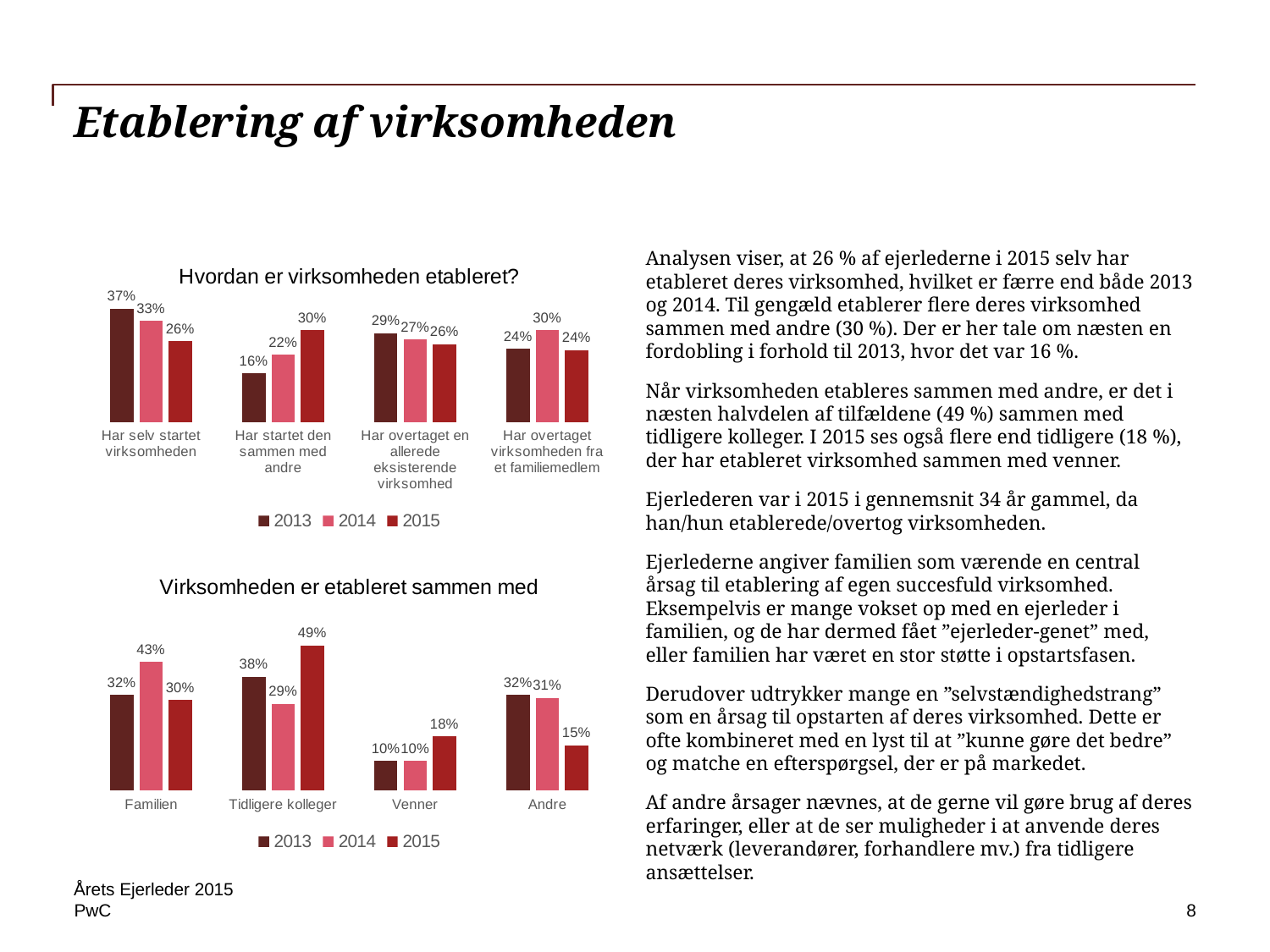
In the chart 'Virksomheden er etableret sammen med', which category has the lowest 2014 value? Venner In the chart 'Virksomheden er etableret sammen med', what is the 2015 value for 'Tidligere kolleger'? 49% In the chart 'Hvordan er virksomheden etableret?', what is the difference between the 2015 and 2013 values for 'Har startet den sammen med andre'? 14% In the chart 'Hvordan er virksomheden etableret?', what is the 2015 value for 'Har selv startet virksomheden'? 26% In the chart 'Hvordan er virksomheden etableret?', what is the 2013 value for 'Har startet den sammen med andre'? 16% In the chart 'Hvordan er virksomheden etableret?', does the value for 'Har selv startet virksomheden' rise or fall from 2013 to 2015? fall How many categories are shown in the chart 'Virksomheden er etableret sammen med'? 4 In the chart 'Virksomheden er etableret sammen med', which is larger: the 2014 value for 'Familien' or the 2014 value for 'Tidligere kolleger'? Familien In the chart 'Virksomheden er etableret sammen med', what is the difference between the 2015 and 2014 values for 'Venner'? 8% In the chart 'Hvordan er virksomheden etableret?', which category has the highest 2013 value? Har selv startet virksomheden How many series does the legend of the chart 'Hvordan er virksomheden etableret?' list? 3 What type of chart is 'Virksomheden er etableret sammen med'? bar chart